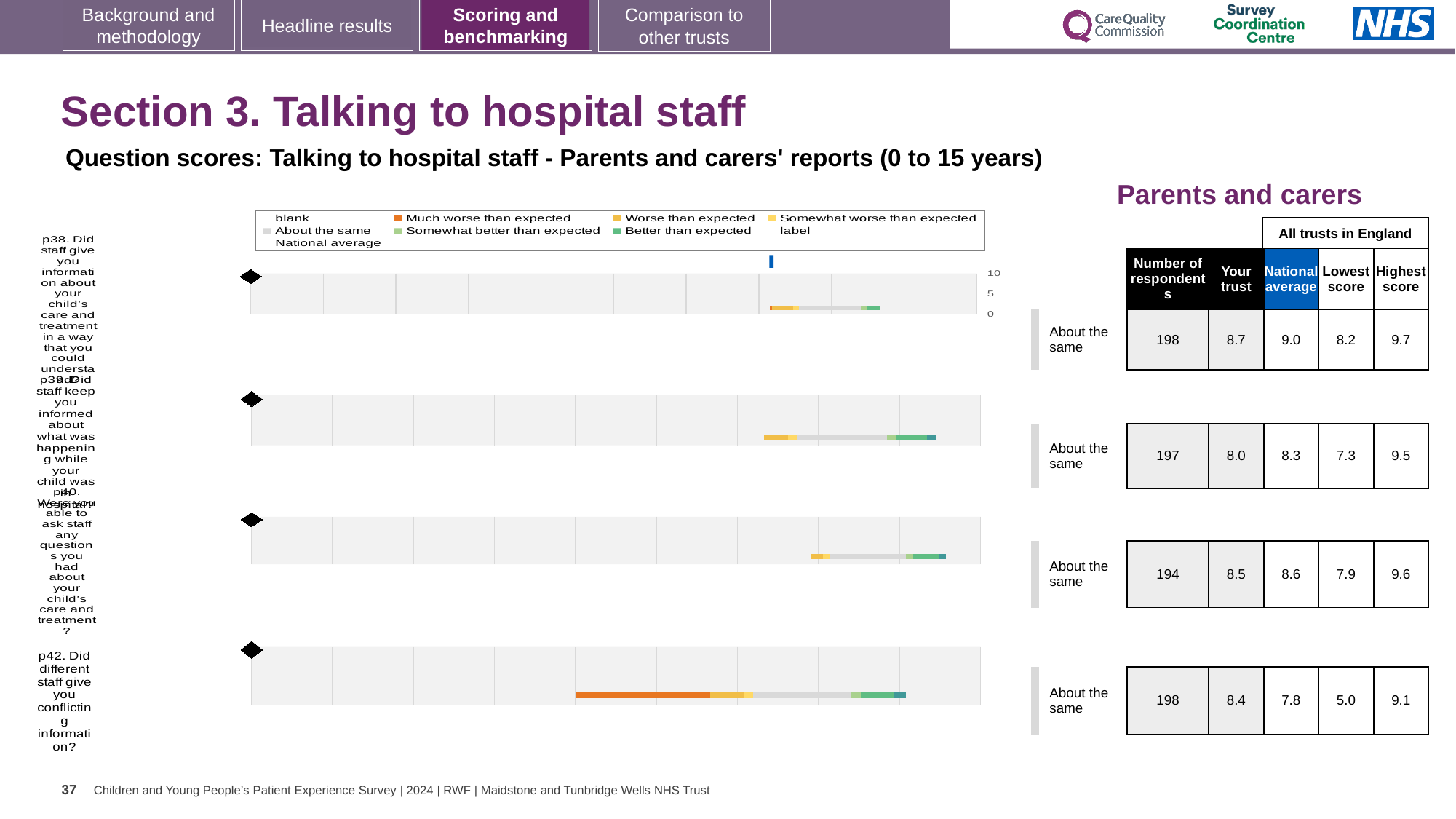
How many respondents answered p39? 197 How many survey questions are plotted in the benchmarking chart? 4 What is the 'Your trust' score for p38 (staff giving information about your child's care in a way you could understand)? 8.7 What is the highest score across all trusts in England for p40 (being able to ask staff questions)? 9.6 Which question has the lowest 'Your trust' score? p39 What benchmark category is shown for p42? About the same What is the national average score for p39 (staff keeping you informed about what was happening)? 8.3 What is the difference between the 'Your trust' score and the national average for p42? 0.6 For p40, is the 'Your trust' score higher or lower than the national average? lower Which question has the highest 'Your trust' score? p38 What kind of chart is used to show the benchmarking results for each question? bar chart What is the lowest score across all trusts in England for p42 (different staff giving conflicting information)? 5.0